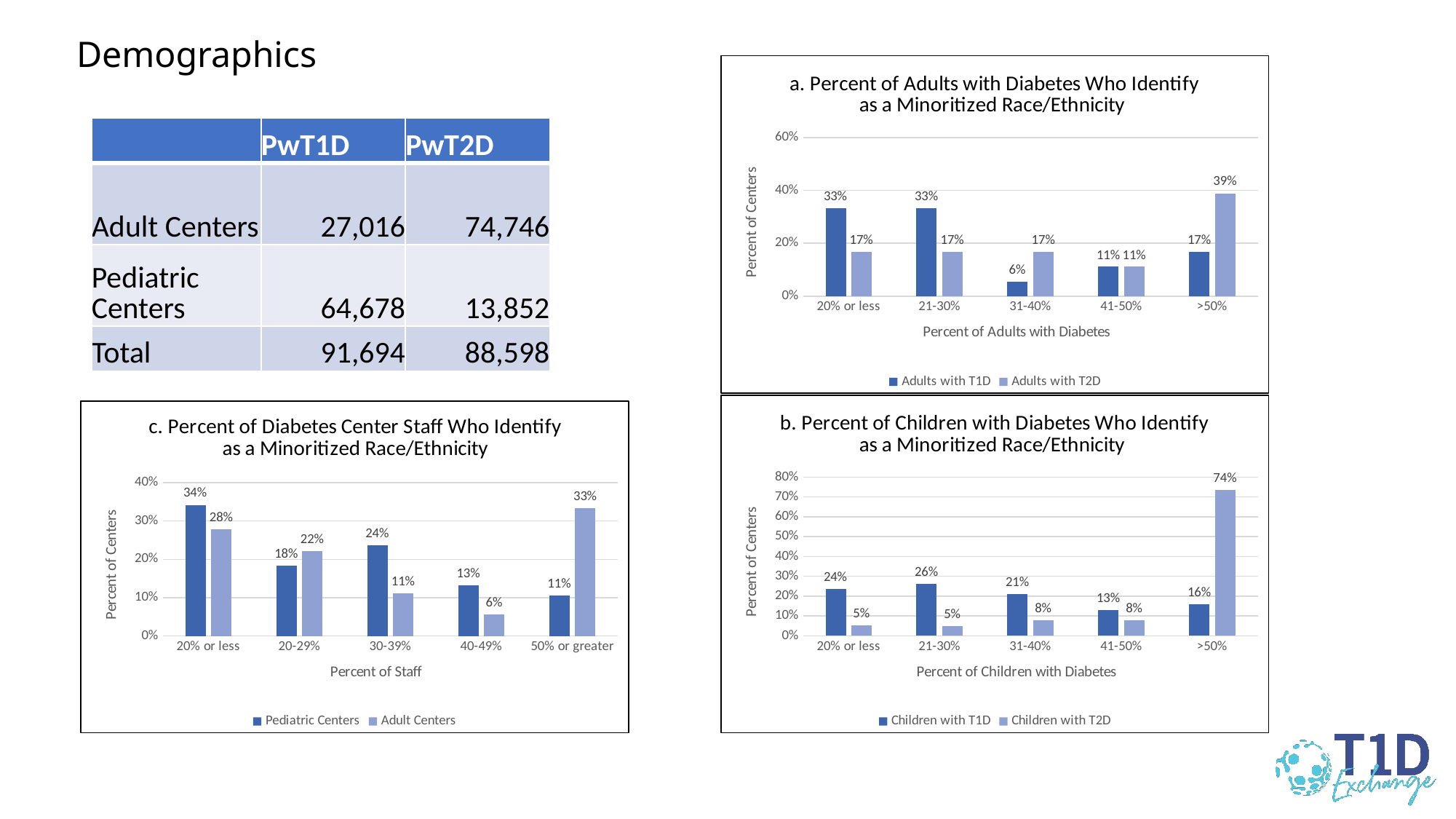
In chart b (Percent of Children with Diabetes Who Identify as a Minoritized Race/Ethnicity), how many series does the legend list? 2 In chart a (Percent of Adults with Diabetes Who Identify as a Minoritized Race/Ethnicity), what is the difference between Adults with T1D and Adults with T2D in the 20% or less category? 16% In chart c (Percent of Diabetes Center Staff Who Identify as a Minoritized Race/Ethnicity), what is the value for Adult Centers in the 50% or greater category? 33% In chart a (Percent of Adults with Diabetes Who Identify as a Minoritized Race/Ethnicity), what is the value for Adults with T2D in the >50% category? 39% In chart c (Percent of Diabetes Center Staff Who Identify as a Minoritized Race/Ethnicity), what is the difference between Pediatric Centers and Adult Centers in the 30-39% category? 13% In chart b (Percent of Children with Diabetes Who Identify as a Minoritized Race/Ethnicity), which category has the highest value for Children with T2D? >50% In chart c (Percent of Diabetes Center Staff Who Identify as a Minoritized Race/Ethnicity), how many categories are shown on the x axis? 5 What kind of chart is chart c (Percent of Diabetes Center Staff Who Identify as a Minoritized Race/Ethnicity)? Bar chart In chart c (Percent of Diabetes Center Staff Who Identify as a Minoritized Race/Ethnicity), which category has the lowest value for Adult Centers? 40-49% In chart b (Percent of Children with Diabetes Who Identify as a Minoritized Race/Ethnicity), which is larger in the 41-50% category: Children with T1D or Children with T2D? Children with T1D In chart b (Percent of Children with Diabetes Who Identify as a Minoritized Race/Ethnicity), what is the value for Children with T1D in the 21-30% category? 26% In chart a (Percent of Adults with Diabetes Who Identify as a Minoritized Race/Ethnicity), what is the value for Adults with T1D in the 31-40% category? 6%